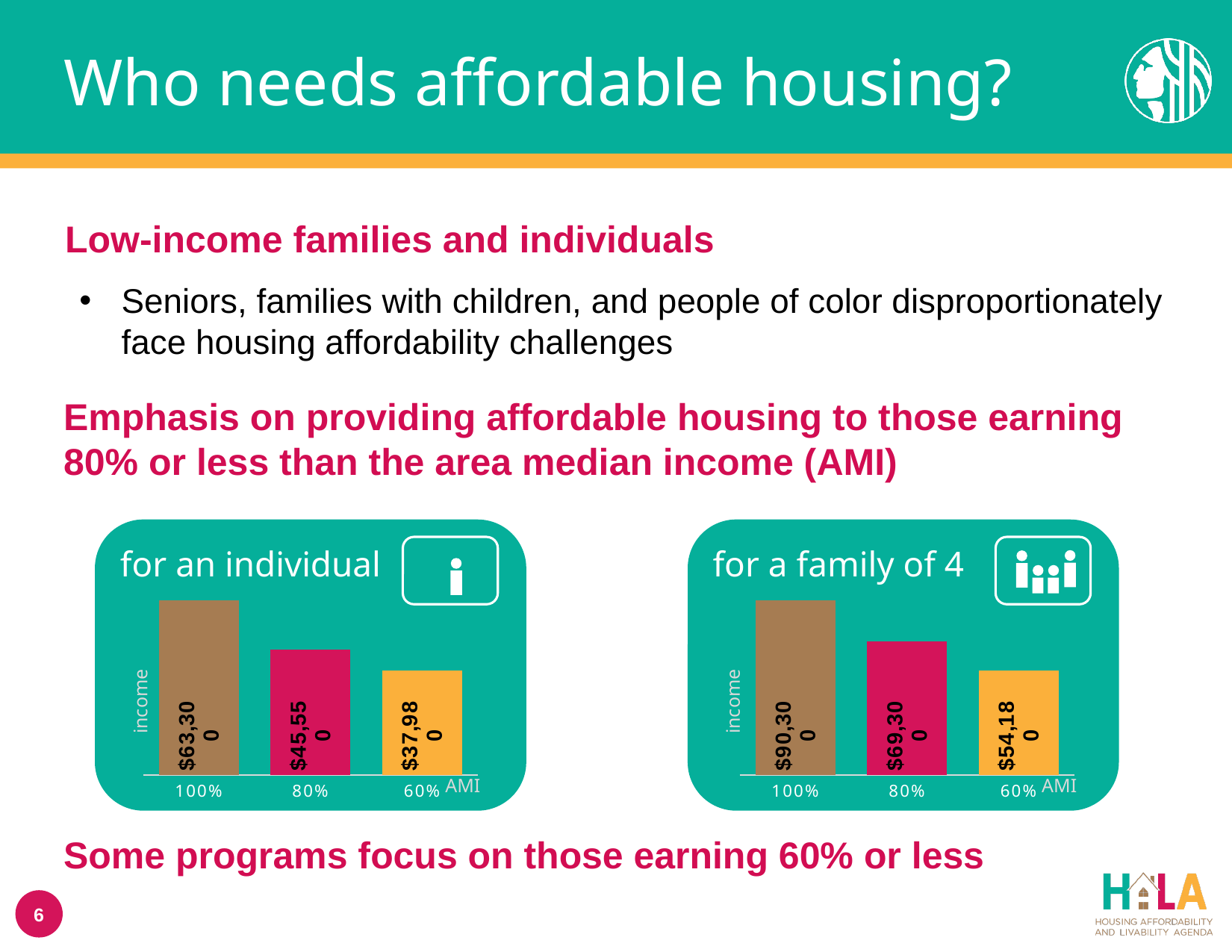
In the 'for a family of 4' chart, what is the income at 60% AMI? $54,180 What type of chart is the 'for a family of 4' chart? Bar chart In the 'for a family of 4' chart, which AMI level has the lowest income? 60% In the 'for a family of 4' chart, what is the income at 100% AMI? $90,300 In the 'for a family of 4' chart, what is the income at 80% AMI? $69,300 In the 'for an individual' chart, what is the income at 80% AMI? $45,550 How many bars are in the 'for an individual' chart? 3 In the 'for an individual' chart, what is the income at 60% AMI? $37,980 In the 'for an individual' chart, which AMI level has the highest income? 100% In the 'for an individual' chart, what is the difference between the income at 80% AMI and at 60% AMI? $7,570 In the 'for an individual' chart, what is the income at 100% AMI? $63,300 In the 'for a family of 4' chart, what is the difference between the income at 100% AMI and at 80% AMI? $21,000